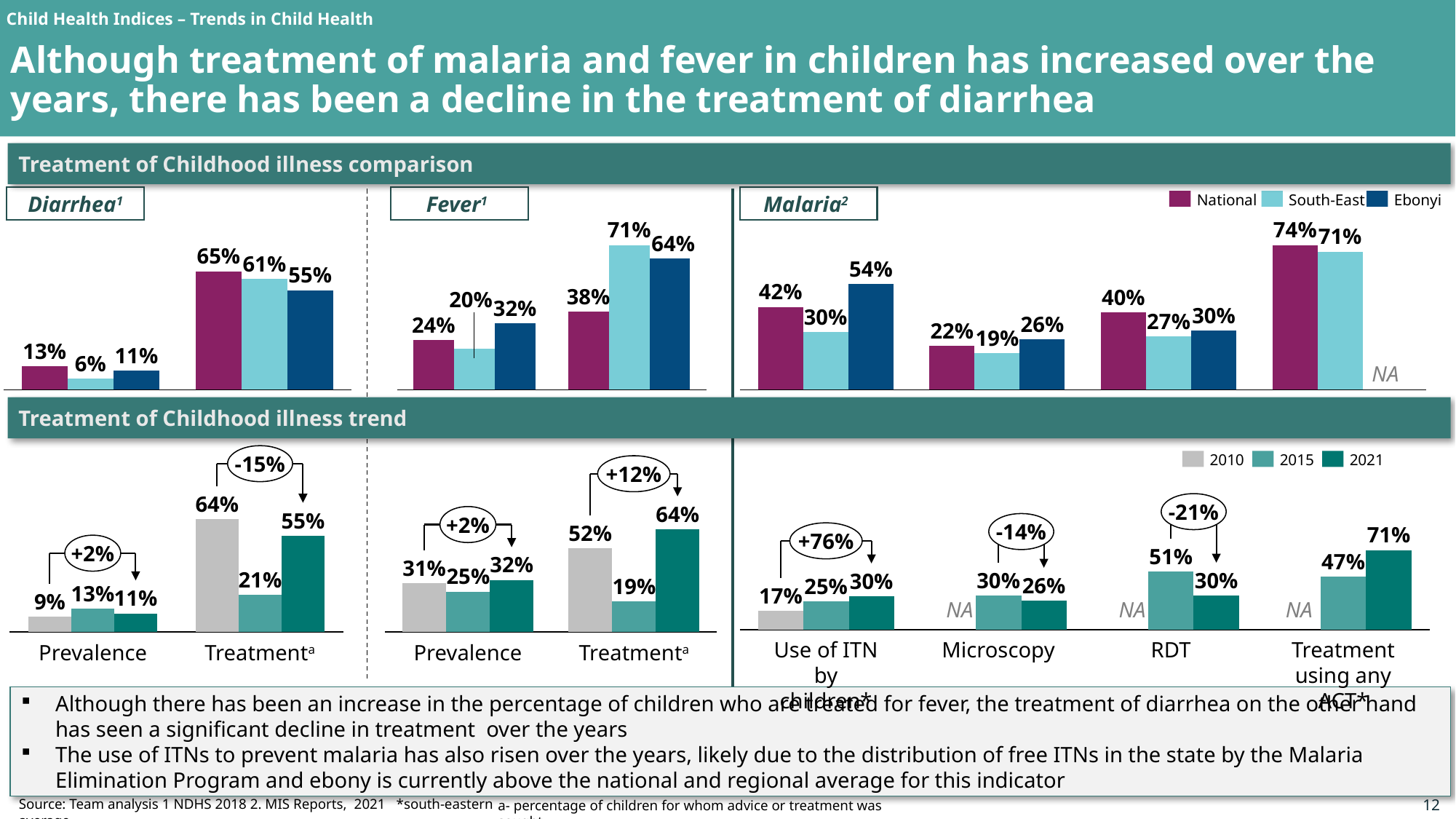
In the 'Fever' comparison chart in the top row, what is the South-East value for the right-hand group of bars? 71% In the 'Malaria' trend chart in the bottom row, is the 2015 value for RDT larger or smaller than the 2021 value for RDT? larger In the 'Malaria' comparison chart in the top row, what is the difference between the National and South-East values in the rightmost group of bars? 3% In the 'Diarrhea' trend chart in the bottom row, what is the difference between the 2010 and 2021 values for Treatment? 9% What type of chart is used for the 'Fever' trend chart in the bottom row? Bar chart How many categories are shown on the x axis of the 'Malaria' trend chart in the bottom row? 4 In the 'Diarrhea' comparison chart in the top row, what is the National value for the right-hand group of bars? 65% How many series does the legend of the top-row comparison charts list? 3 In the 'Malaria' comparison chart in the top row, which series has the highest value in the leftmost group of bars? Ebonyi In the 'Fever' trend chart in the bottom row, which year has the lowest value for Treatment? 2015 In the 'Malaria' trend chart in the bottom row, what is the 2021 value for Treatment using any ACT? 71% In the 'Diarrhea' trend chart in the bottom row, what is the 2015 value for Treatment? 21%